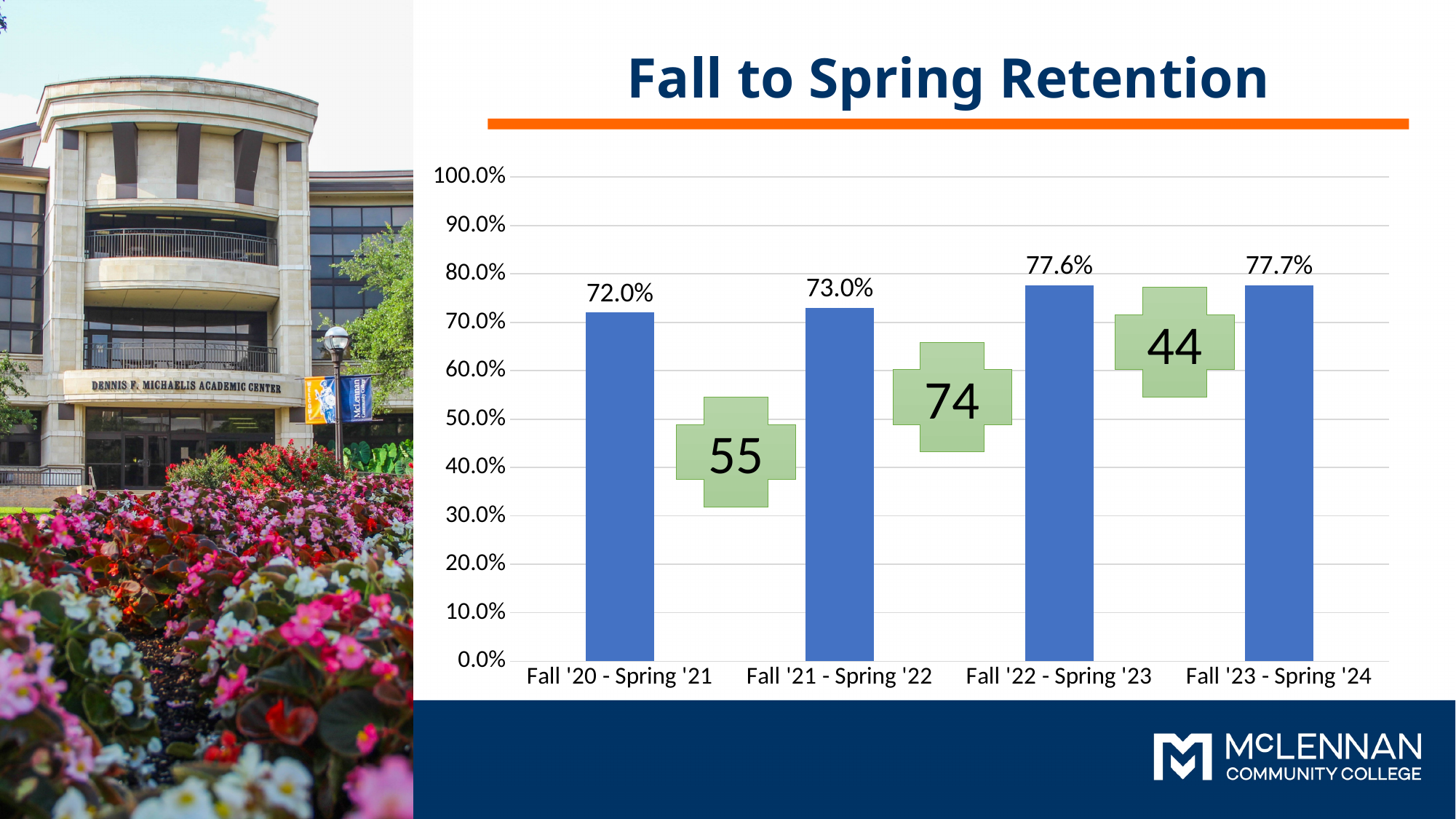
What is the difference in retention rate between Fall '21 - Spring '22 and Fall '20 - Spring '21? 1.0% Which period has the lowest Fall to Spring retention rate? Fall '20 - Spring '21 How many periods are shown on the chart? 4 What is the Fall to Spring retention rate for Fall '20 - Spring '21? 72.0% What is the difference in retention rate between Fall '22 - Spring '23 and Fall '21 - Spring '22? 4.6% What is the Fall to Spring retention rate for Fall '23 - Spring '24? 77.7% Do the retention rates rise or fall from Fall '20 - Spring '21 to Fall '23 - Spring '24? Rise Which is larger, the retention rate for Fall '21 - Spring '22 or for Fall '22 - Spring '23? Fall '22 - Spring '23 What kind of chart is shown on the slide? Bar chart Is the retention rate for Fall '20 - Spring '21 greater or less than 80.0%? less Which period has the highest Fall to Spring retention rate? Fall '23 - Spring '24 What is the Fall to Spring retention rate for Fall '22 - Spring '23? 77.6%